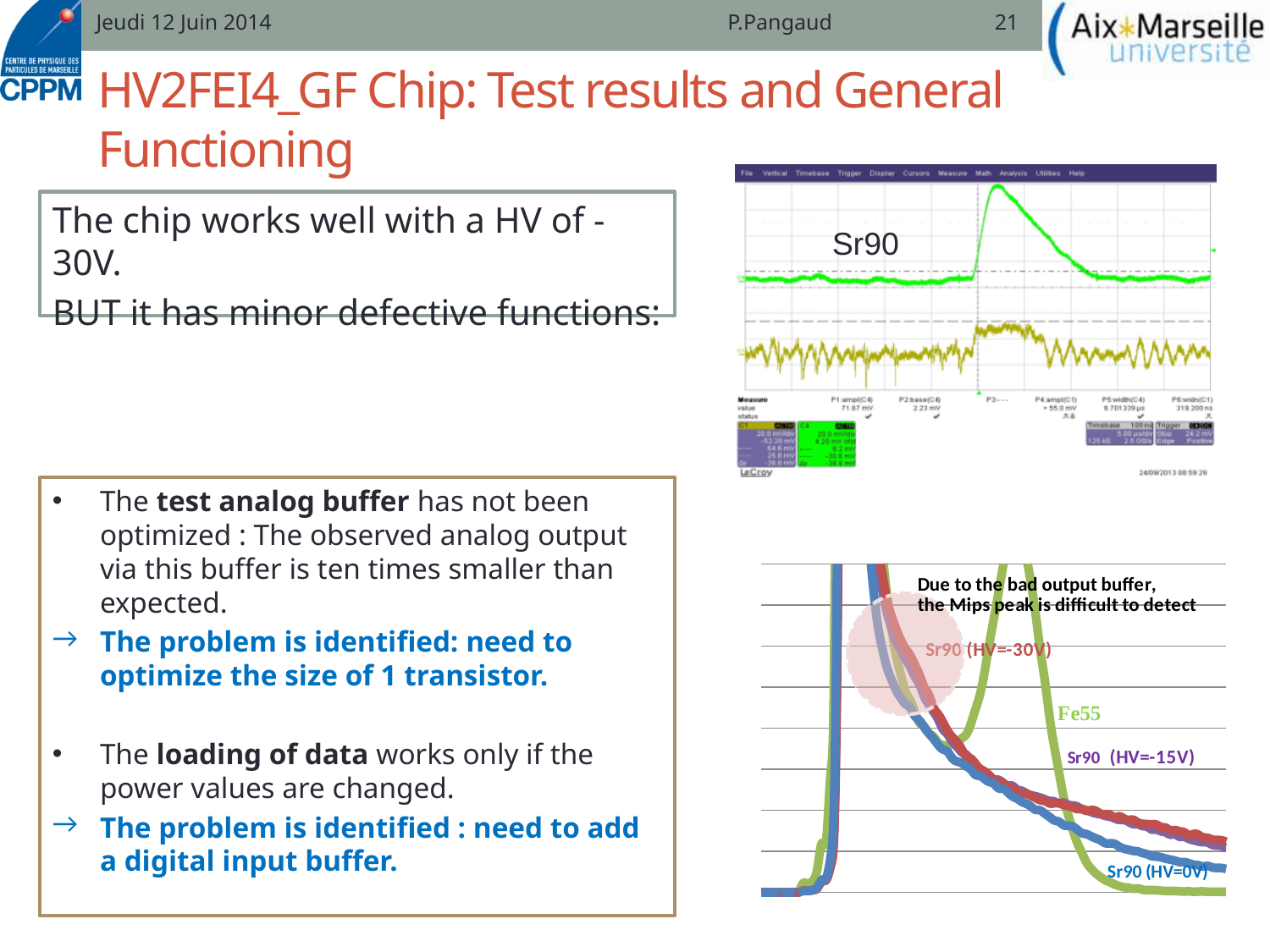
In the top-right oscilloscope chart, what is the value shown for P2 base(C4)? 2.23 mV In the top-right oscilloscope chart, what is the value shown for P1 ampl(C4)? 71.67 mV What kind of chart is the bottom-right chart on the slide? line chart In the bottom-right chart, what HV value is given for the Sr90 curve labelled at the bottom right? HV=0V In the bottom-right chart, what colour is the curve labelled Fe55? green How many different HV values are listed for Sr90 in the bottom-right chart? 3 In the bottom-right chart, what HV value is given for the Sr90 curve labelled in purple? HV=-15V What source is labelled on the top-right oscilloscope chart? Sr90 In the top-right oscilloscope chart, what is the value shown for P6 width(C1)? 319.200 ns In the bottom-right chart, what colour is the curve labelled Sr90 (HV=-30V)? red